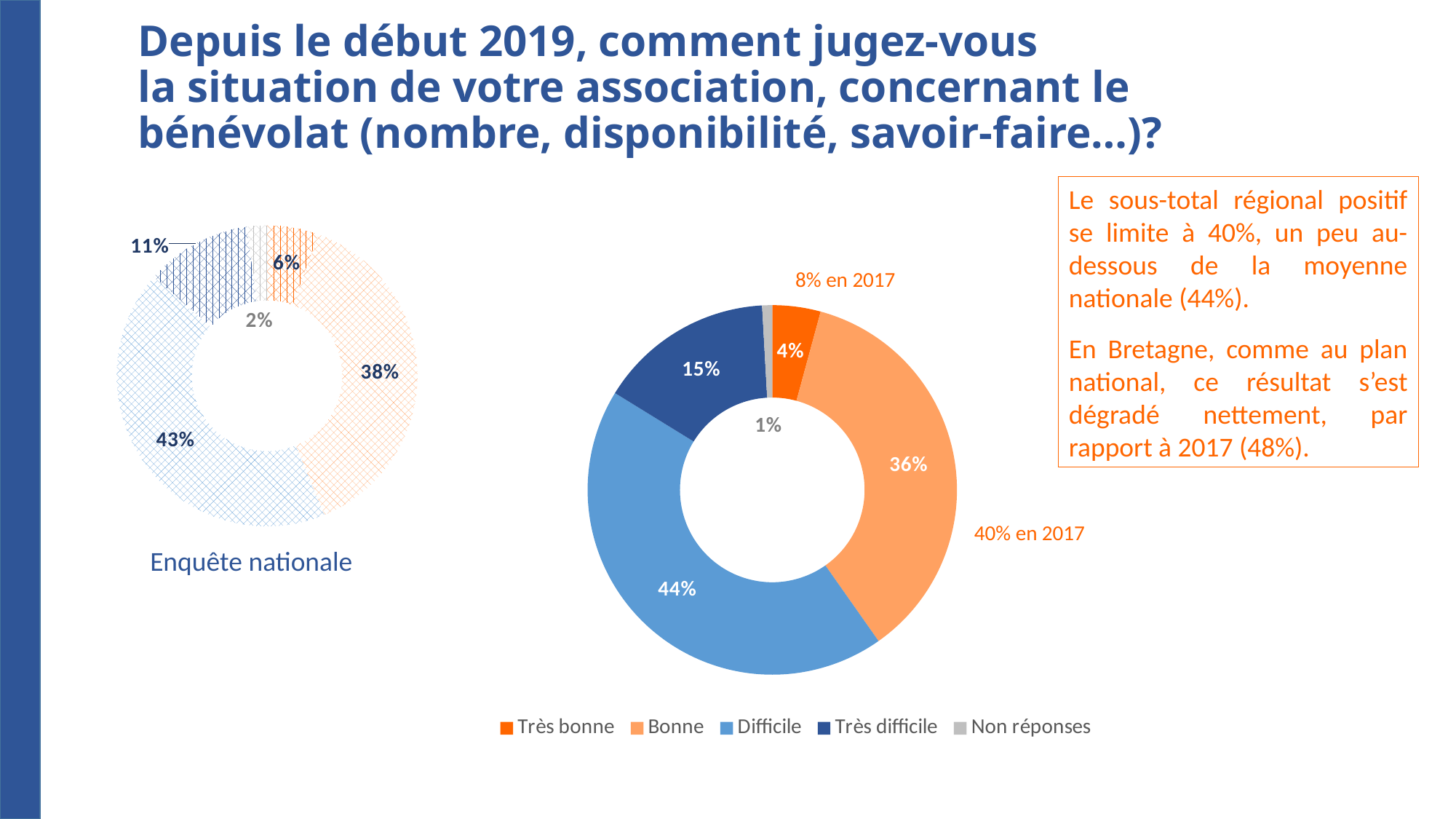
On the larger donut chart in the centre of the slide, what is the value for Difficile? 44% On the larger donut chart in the centre of the slide, which category has the largest share? Difficile On the larger donut chart in the centre of the slide, what is the value for Très bonne? 4% On the larger donut chart in the centre of the slide, what is the value for Très difficile? 15% On the larger donut chart in the centre of the slide, what is the difference between the Difficile and Bonne shares? 8% On the larger donut chart in the centre of the slide, which category has the smallest share? Non réponses What kind of chart is the larger chart in the centre of the slide? Donut (pie) chart According to the annotation on the larger donut chart, what was the Bonne share in 2017? 40% On the 'Enquête nationale' donut chart on the left, what is the value for Bonne? 38% On the 'Enquête nationale' donut chart on the left, what is the value for Difficile? 43% How many categories does the legend at the bottom of the slide list? 5 On the 'Enquête nationale' donut chart on the left, which is larger: Très difficile or Très bonne? Très difficile